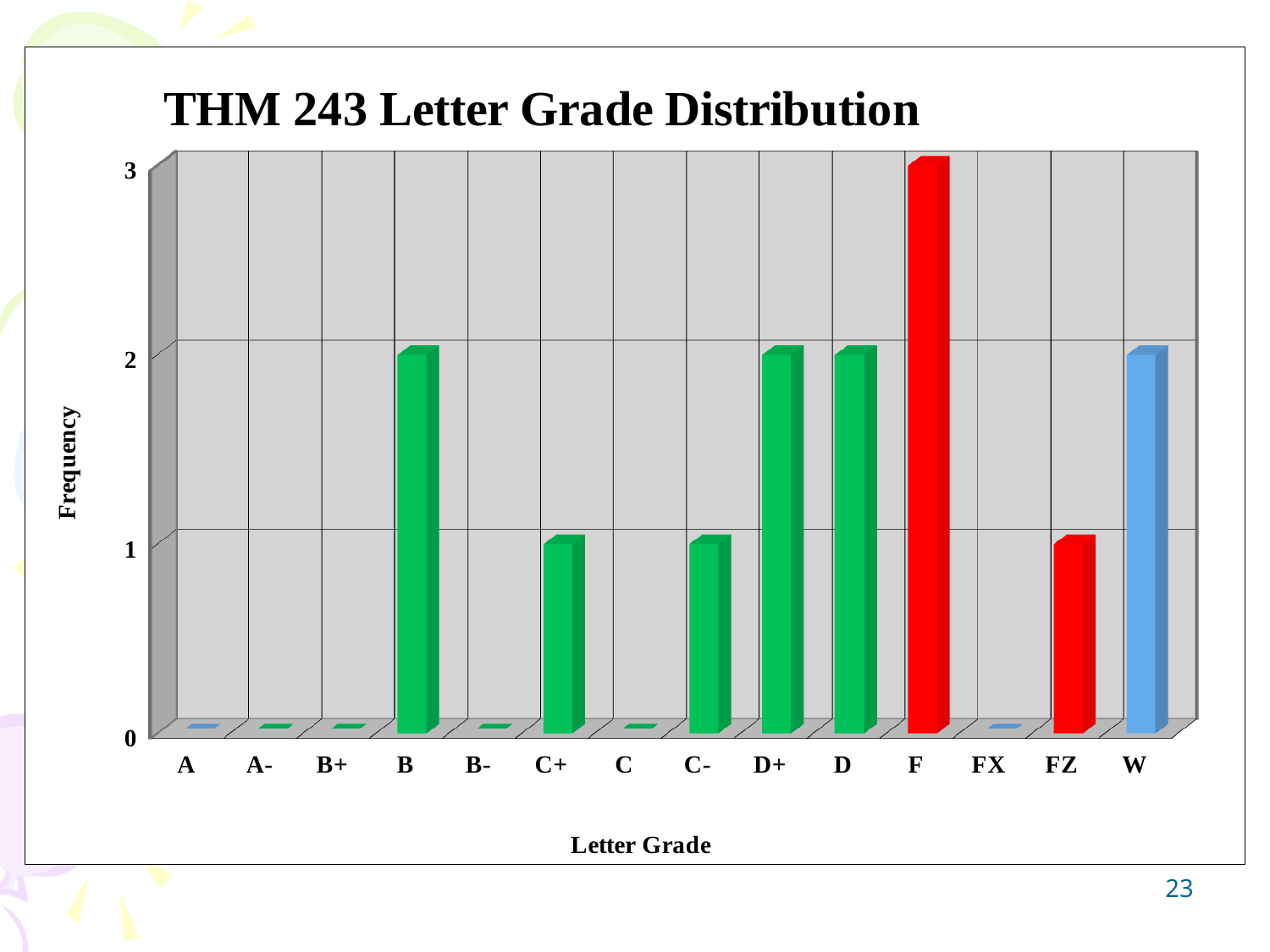
What is the frequency for letter grade W? 2 Which letter grade has the highest frequency? F What is the frequency for letter grade C+? 1 Is the frequency for D+ greater or less than 1? greater Which has a higher frequency, B or C-? B How many letter grade categories are shown on the x axis? 14 What kind of chart is shown on the slide? Bar chart What is the label of the y axis? Frequency What is the difference in frequency between F and FZ? 2 What is the frequency for letter grade F? 3 What is the title of the chart? THM 243 Letter Grade Distribution What is the frequency for letter grade B? 2